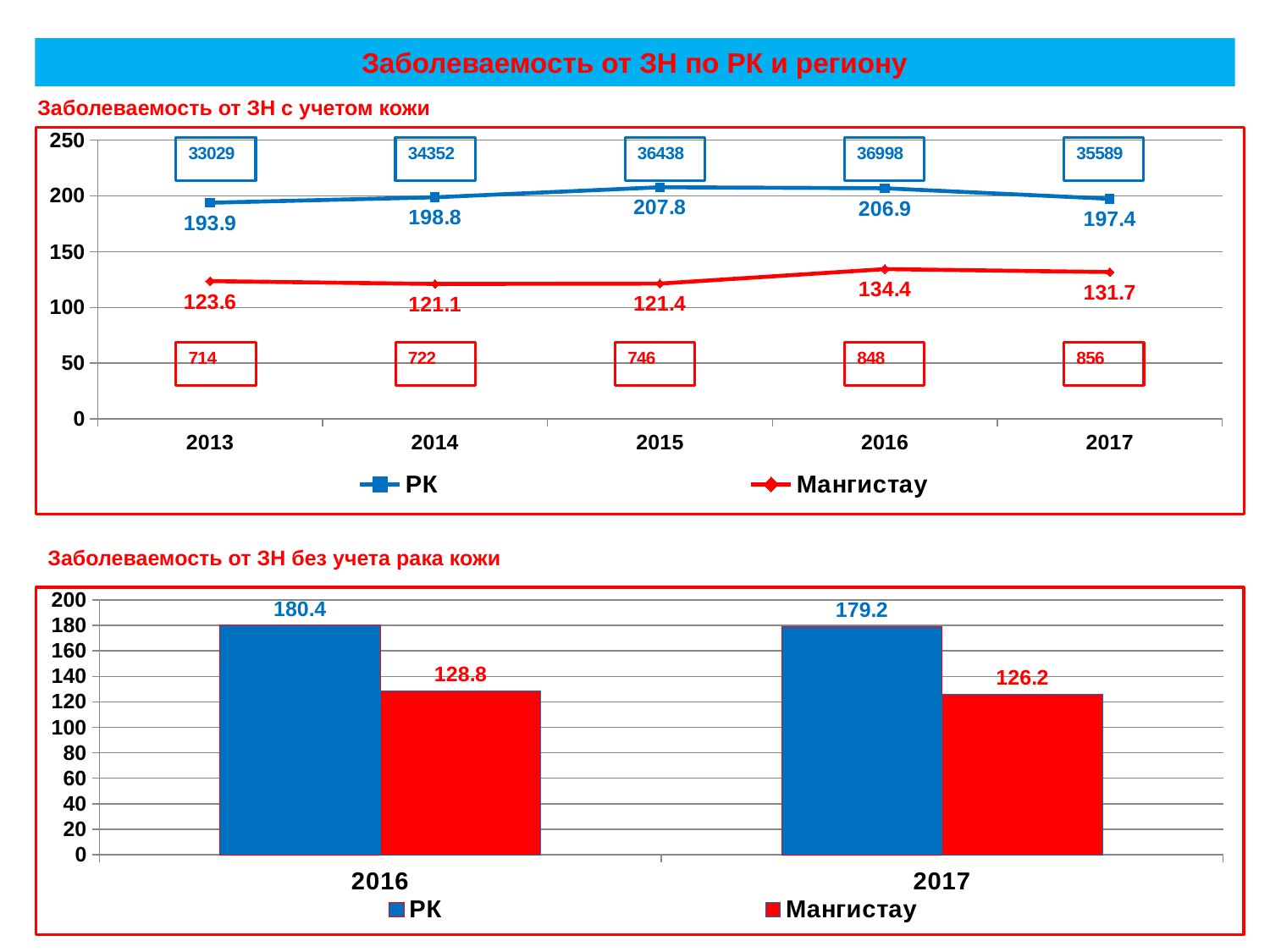
In the top chart (Заболеваемость от ЗН с учетом кожи), what is the value for РК in 2015? 207.8 In the top chart (Заболеваемость от ЗН с учетом кожи), in which year is the Мангистау value lowest? 2014 In the top chart (Заболеваемость от ЗН с учетом кожи), does the Мангистау value rise or fall from 2016 to 2017? fall In the bottom chart (Заболеваемость от ЗН без учета рака кожи), which is larger: Мангистау in 2016 or Мангистау in 2017? Мангистау in 2016 In the top chart (Заболеваемость от ЗН с учетом кожи), what kind of chart is it? line chart In the top chart (Заболеваемость от ЗН с учетом кожи), in which year is the РК value highest? 2015 In the top chart (Заболеваемость от ЗН с учетом кожи), what is the value for Мангистау in 2016? 134.4 In the bottom chart (Заболеваемость от ЗН без учета рака кожи), what is the value for РК in 2016? 180.4 In the top chart (Заболеваемость от ЗН с учетом кожи), how many years are shown on the x axis? 5 In the bottom chart (Заболеваемость от ЗН без учета рака кожи), how many series does the legend list? 2 In the top chart (Заболеваемость от ЗН с учетом кожи), what is the difference between the РК and Мангистау values in 2013? 70.3 In the bottom chart (Заболеваемость от ЗН без учета рака кожи), what is the difference between the РК and Мангистау values in 2017? 53.0